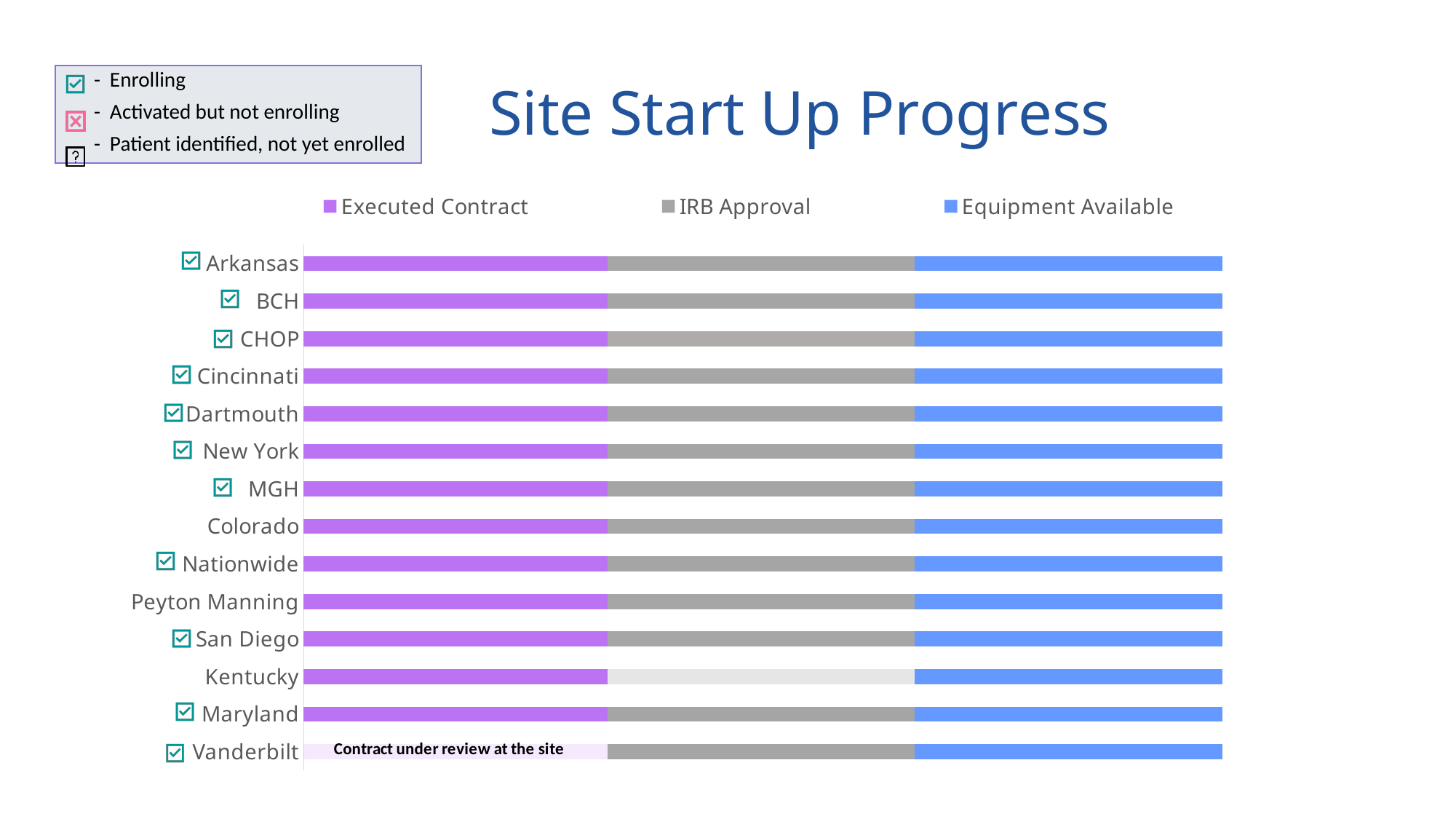
What is the title of the slide? Site Start Up Progress Which site is listed last (at the bottom) of the chart? Vanderbilt Which site has its IRB Approval segment shown faded (light grey) rather than solid grey? Kentucky Which series is shown in purple in the legend? Executed Contract How many series does the chart legend list? 3 How many sites are listed on the chart? 14 Which site has the note "Contract under review at the site" in place of its Executed Contract segment? Vanderbilt Which site is listed first (at the top) of the chart? Arkansas What kind of chart is shown on the slide? Stacked bar chart